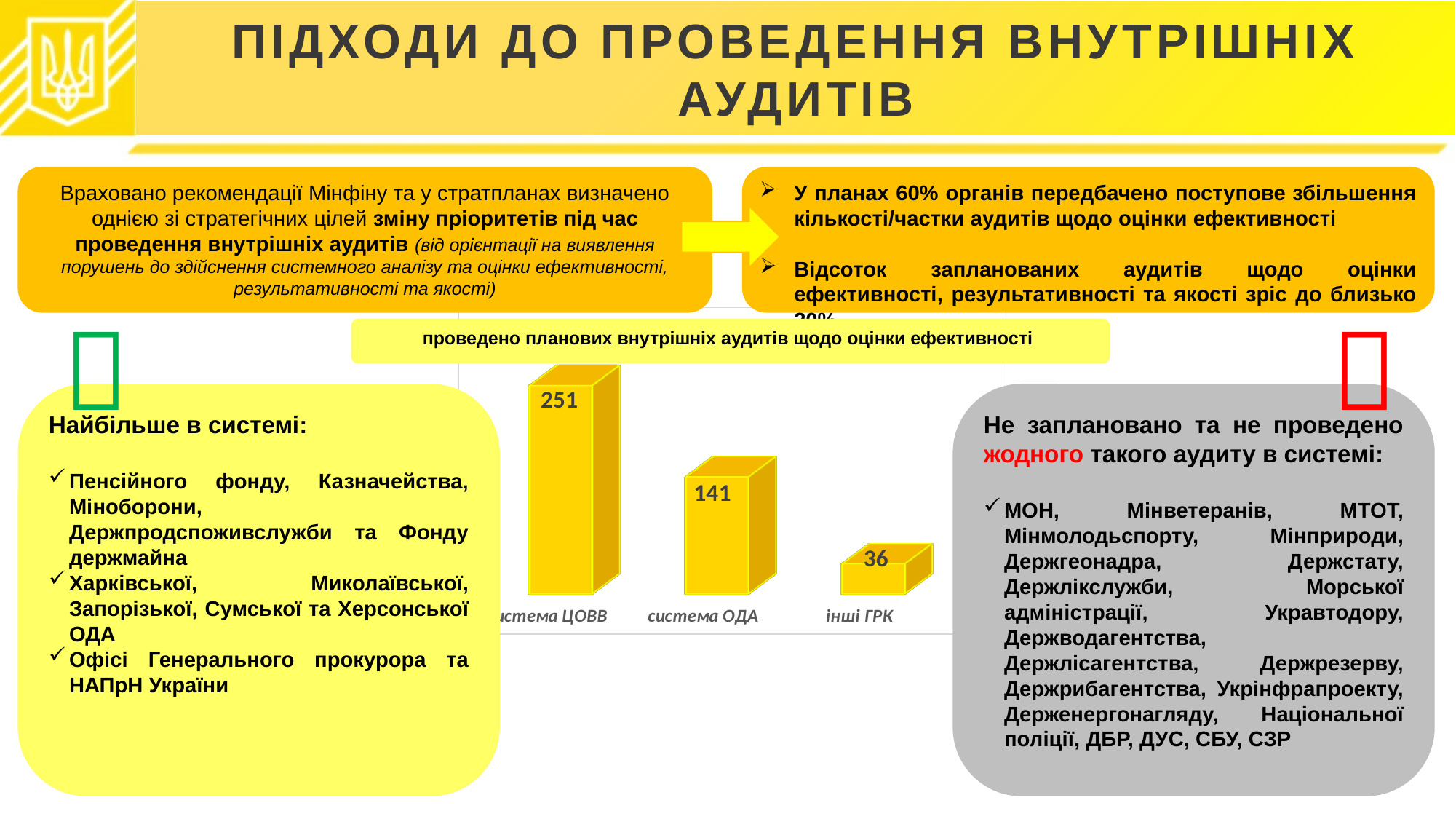
What is the difference between the values for система ЦОВВ and система ОДА? 110 Do the values rise or fall from left to right across the categories? fall How many categories are shown in the chart? 3 What value is shown for система ЦОВВ? 251 Which category has the highest value? система ЦОВВ Which category has the lowest value? інші ГРК What kind of chart is shown on the slide? bar chart What value is shown for система ОДА? 141 What value is shown for інші ГРК? 36 What is the difference between the values for система ОДА and інші ГРК? 105 Which is larger, the value for система ОДА or the value for інші ГРК? система ОДА What is the title of the chart? проведено планових внутрішніх аудитів щодо оцінки ефективності